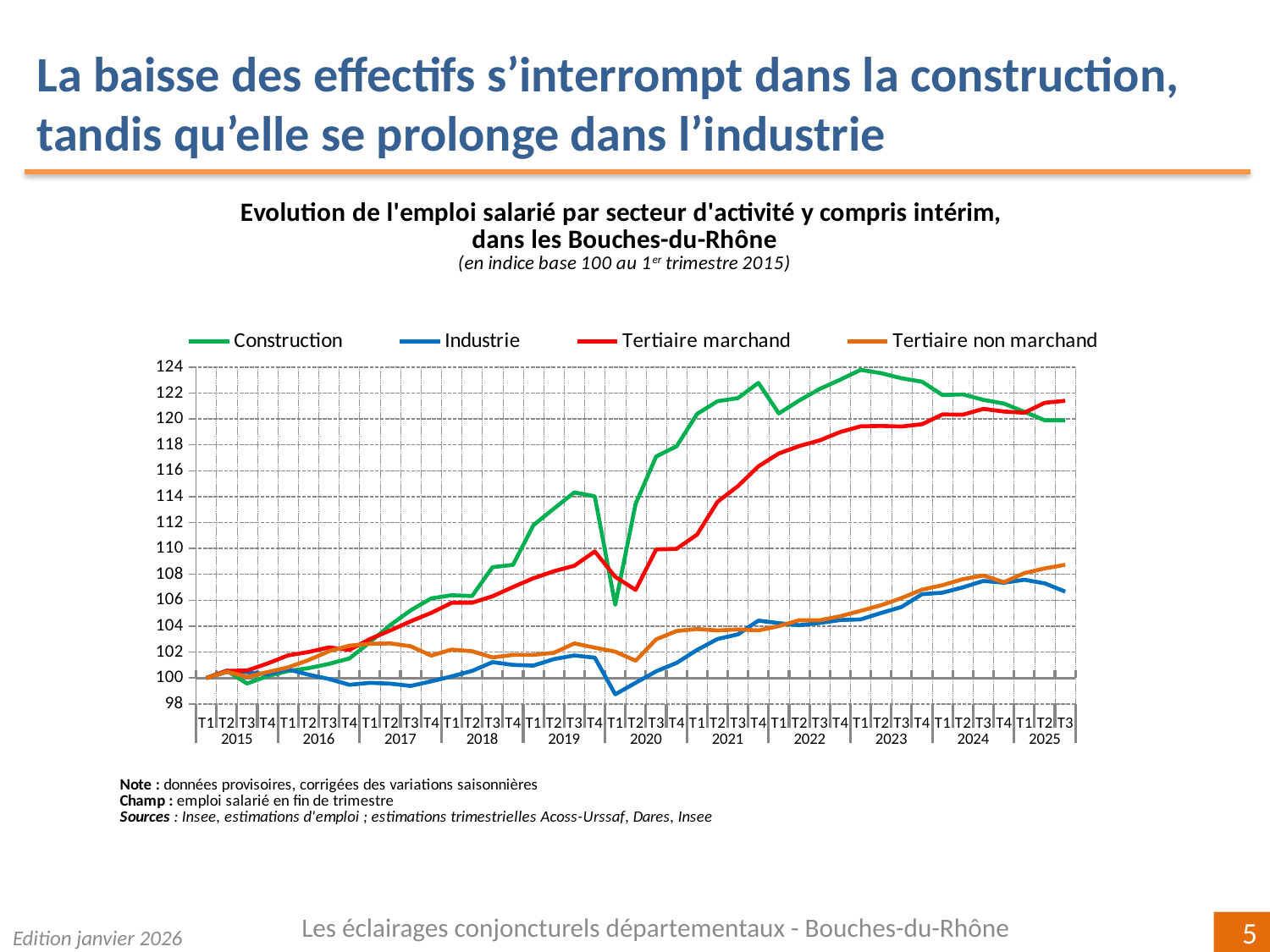
How many series does the legend list? 4 Is the value for Tertiaire marchand at T4 2022 greater or less than 116? greater What kind of chart is shown on the slide? line chart Does the Construction series rise or fall between T1 2023 and T3 2025? fall Is the value for Industrie at T1 2020 greater or less than 100? less Which series is highest at T1 2023? Construction Is the value for Construction at T1 2023 greater or less than 122? greater How many years are labelled on the x axis? 11 Which series is lowest at T1 2020? Industrie Which series is lowest at T3 2025? Industrie At T3 2025, which is larger: Tertiaire marchand or Construction? Tertiaire marchand Does the Industrie series rise or fall between T1 2021 and T3 2024? rise